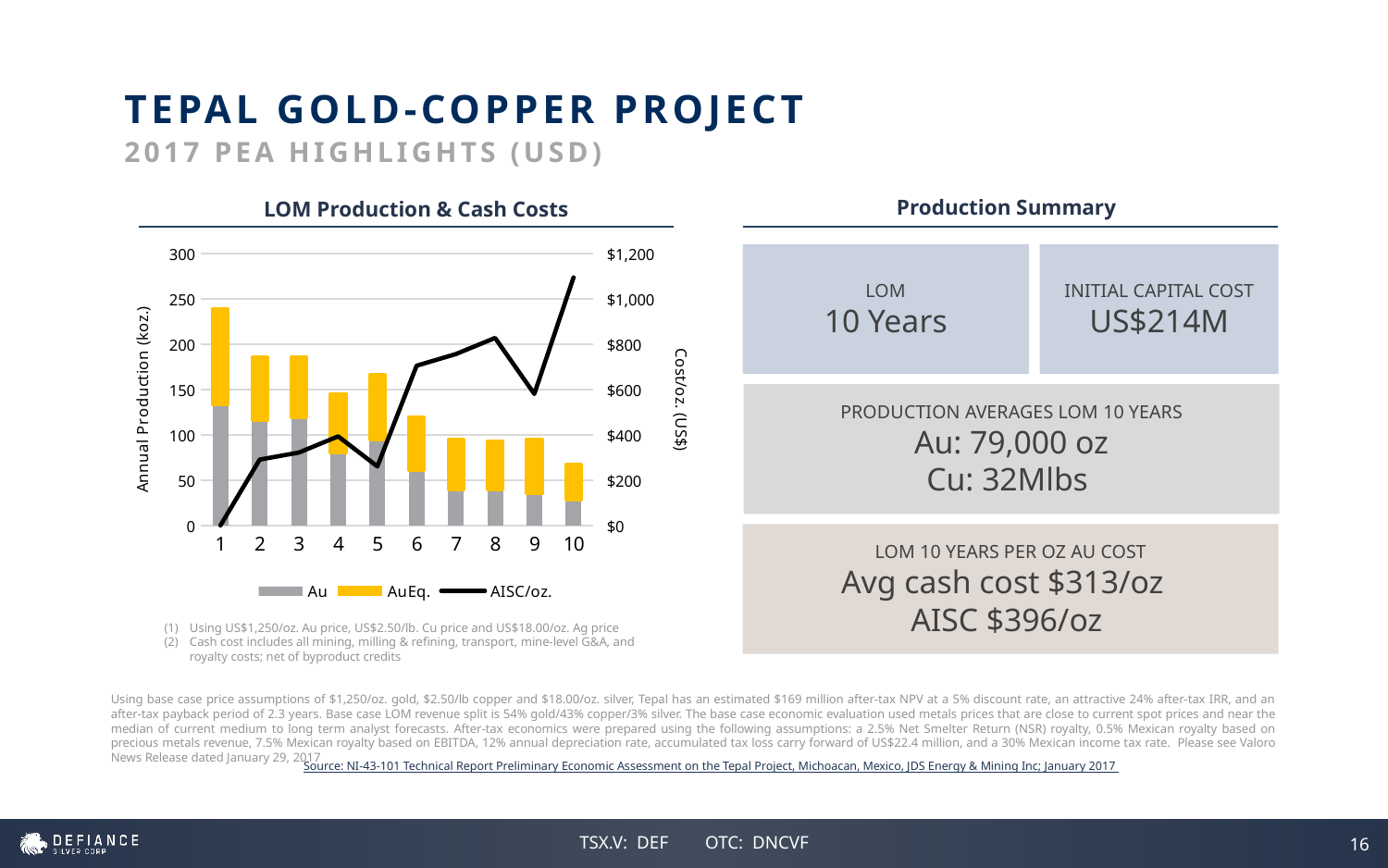
What is the label of the left vertical axis of the LOM Production & Cash Costs chart? Annual Production (koz.) In the LOM Production & Cash Costs chart, which year has the highest AISC/oz. value? 10 In the LOM Production & Cash Costs chart, is the total stacked bar for year 1 greater or less than 200? greater In the LOM Production & Cash Costs chart, which year has the highest total stacked bar? 1 How many series does the legend of the LOM Production & Cash Costs chart list? 3 In the LOM Production & Cash Costs chart, which year has the lowest total stacked bar? 10 In the LOM Production & Cash Costs chart, does the total annual production generally rise or fall from year 1 to year 10? Fall What are the legend entries of the LOM Production & Cash Costs chart? Au, AuEq., AISC/oz. How many years (categories) are shown on the x axis of the LOM Production & Cash Costs chart? 10 In the LOM Production & Cash Costs chart, is the AISC/oz. value for year 10 greater or less than $1,000? greater What kind of chart is the LOM Production & Cash Costs chart? Bar chart with a line In the LOM Production & Cash Costs chart, is the AISC/oz. value for year 5 greater or less than $400? less